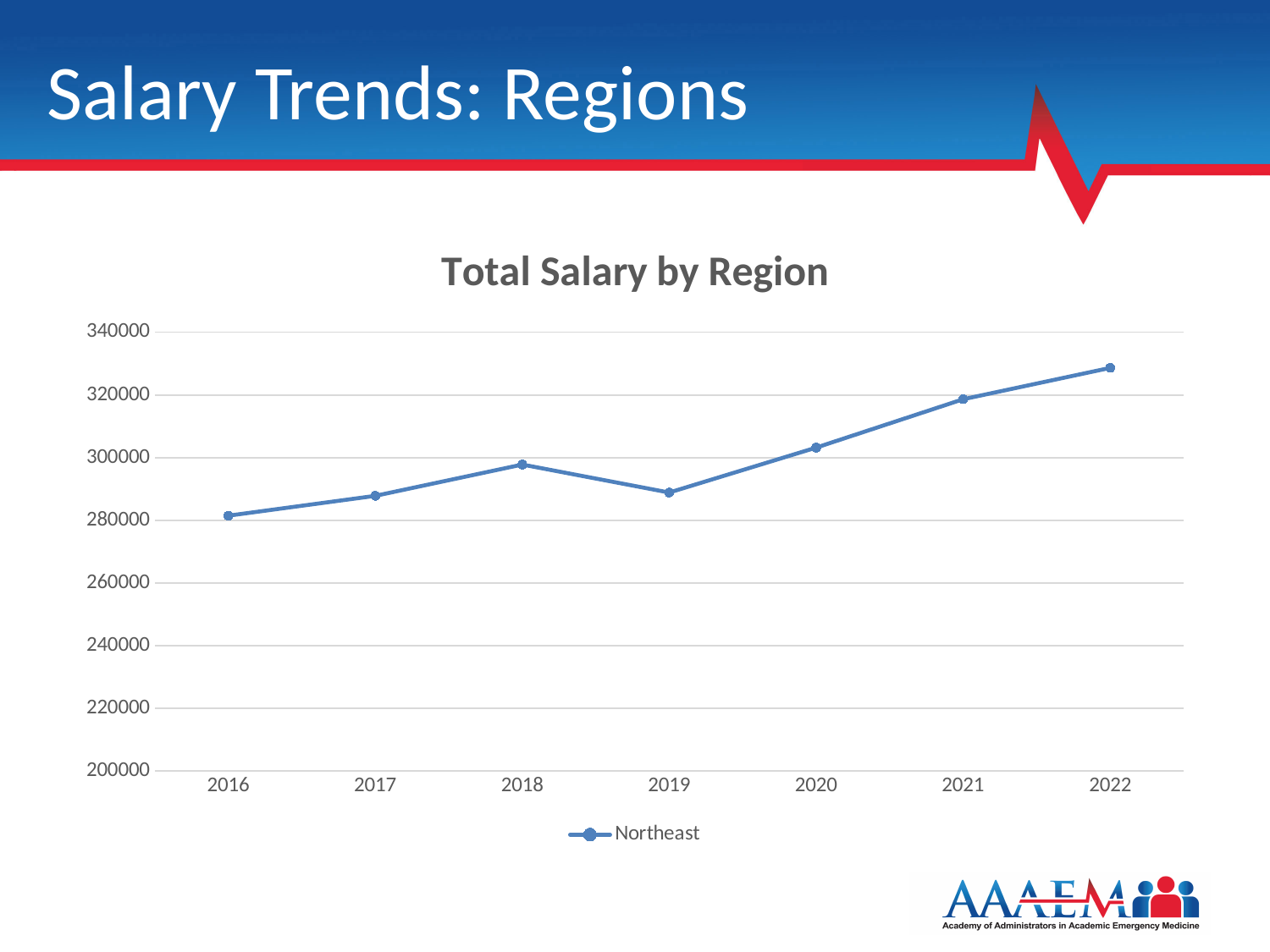
In which year is the Northeast total salary lowest? 2016 How many years are plotted on the x axis? 7 Is the value for 2022 greater or less than 320000? greater What is the title of the chart? Total Salary by Region Which year has the larger value, 2018 or 2019? 2018 Is the value for 2016 greater or less than 300000? less Is the value for 2019 greater or less than 300000? less How many series does the legend list? 1 Overall, does the Northeast total salary rise or fall from 2016 to 2022? Rise What kind of chart is shown on the slide? Line chart In which year is the Northeast total salary highest? 2022 What series name appears in the legend? Northeast